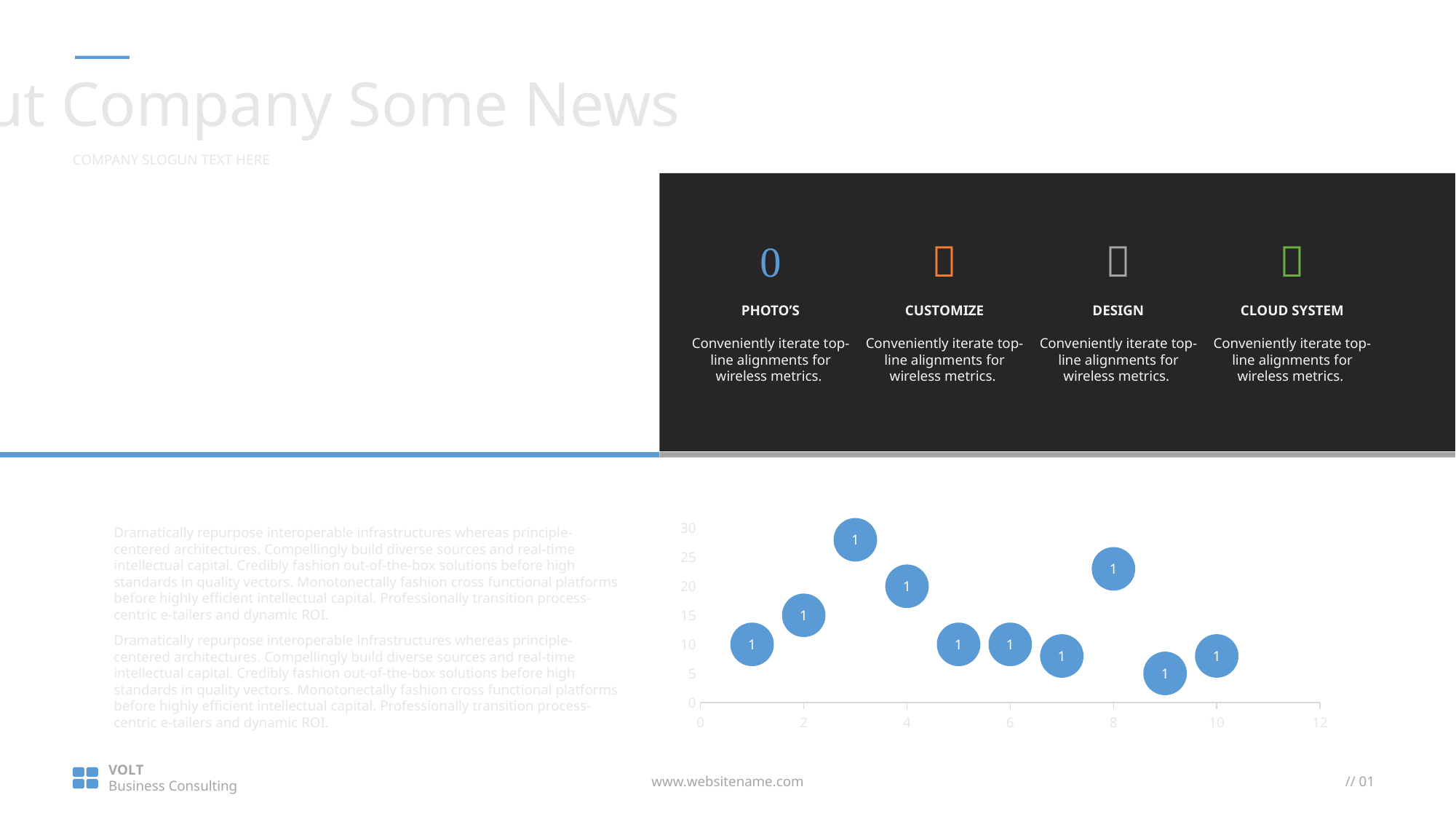
What kind of chart is shown at the bottom of the slide? bubble chart Is the y value of the bubble at x = 7 greater or less than 10? less Is the y value of the bubble at x = 10 greater or less than 10? less Which bubble has the higher y value, the one at x = 4 or the one at x = 2? x = 4 Is the y value of the bubble at x = 3 greater or less than 25? greater At which x value is the lowest bubble in the chart? 9 How many bubbles are plotted in the chart? 10 Which bubble has the higher y value, the one at x = 3 or the one at x = 8? x = 3 What is the highest value shown on the chart's vertical axis? 30 What data label is printed inside each bubble of the chart? 1 At which x value is the highest bubble in the chart? 3